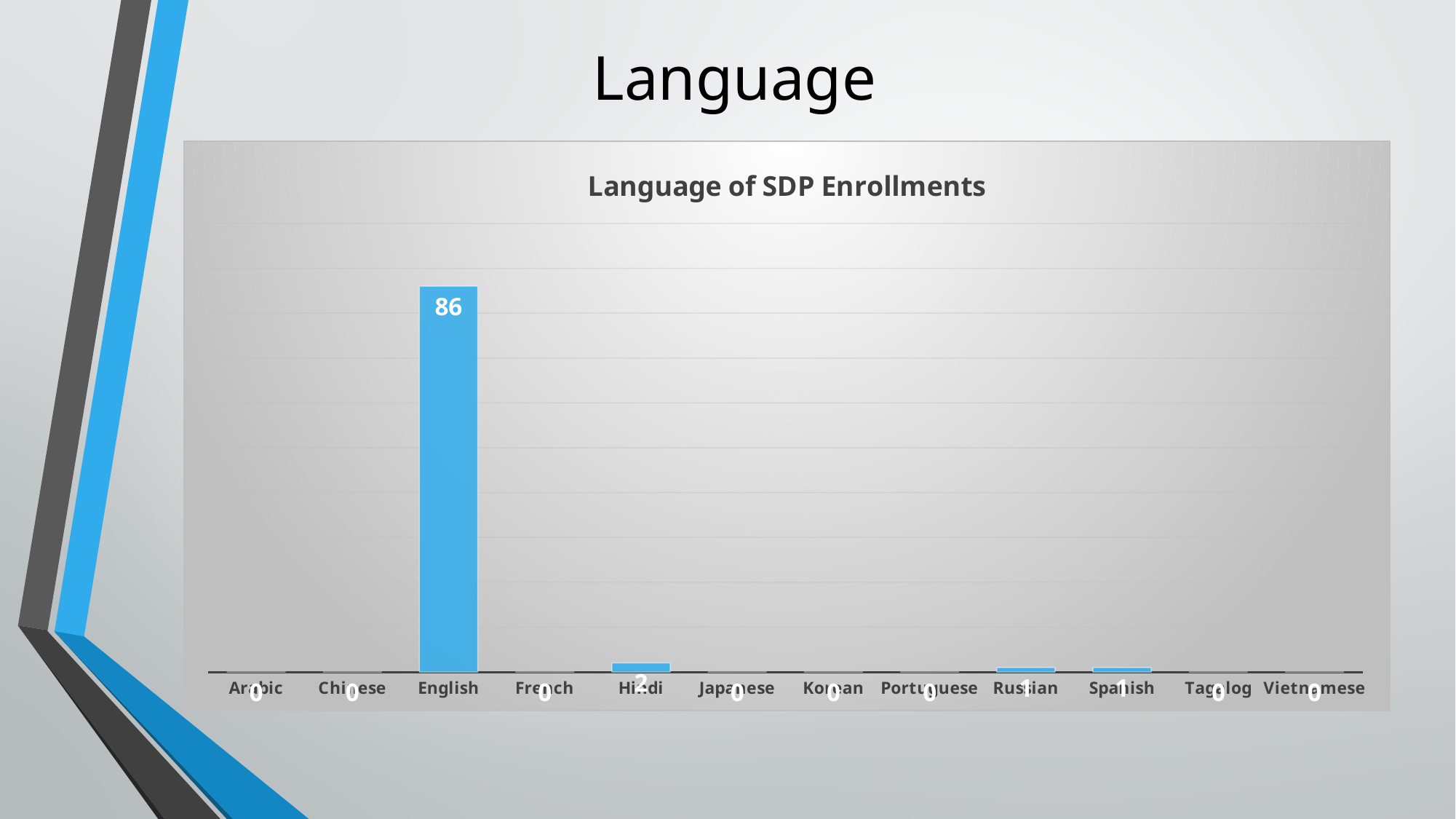
What is the value for Hindi in the Language of SDP Enrollments chart? 2 What kind of chart is shown on the slide? Bar chart What is the value for Spanish in the Language of SDP Enrollments chart? 1 What is the value for English in the Language of SDP Enrollments chart? 86 Which has a larger value, English or Hindi? English What is the difference between the values for Hindi and Spanish? 1 What is the difference between the values for English and Hindi? 84 How many language categories are shown on the x axis of the chart? 12 Which language has the highest number of SDP enrollments? English What is the value for Russian in the Language of SDP Enrollments chart? 1 What is the value for Arabic in the Language of SDP Enrollments chart? 0 What is the title of the chart on the slide? Language of SDP Enrollments